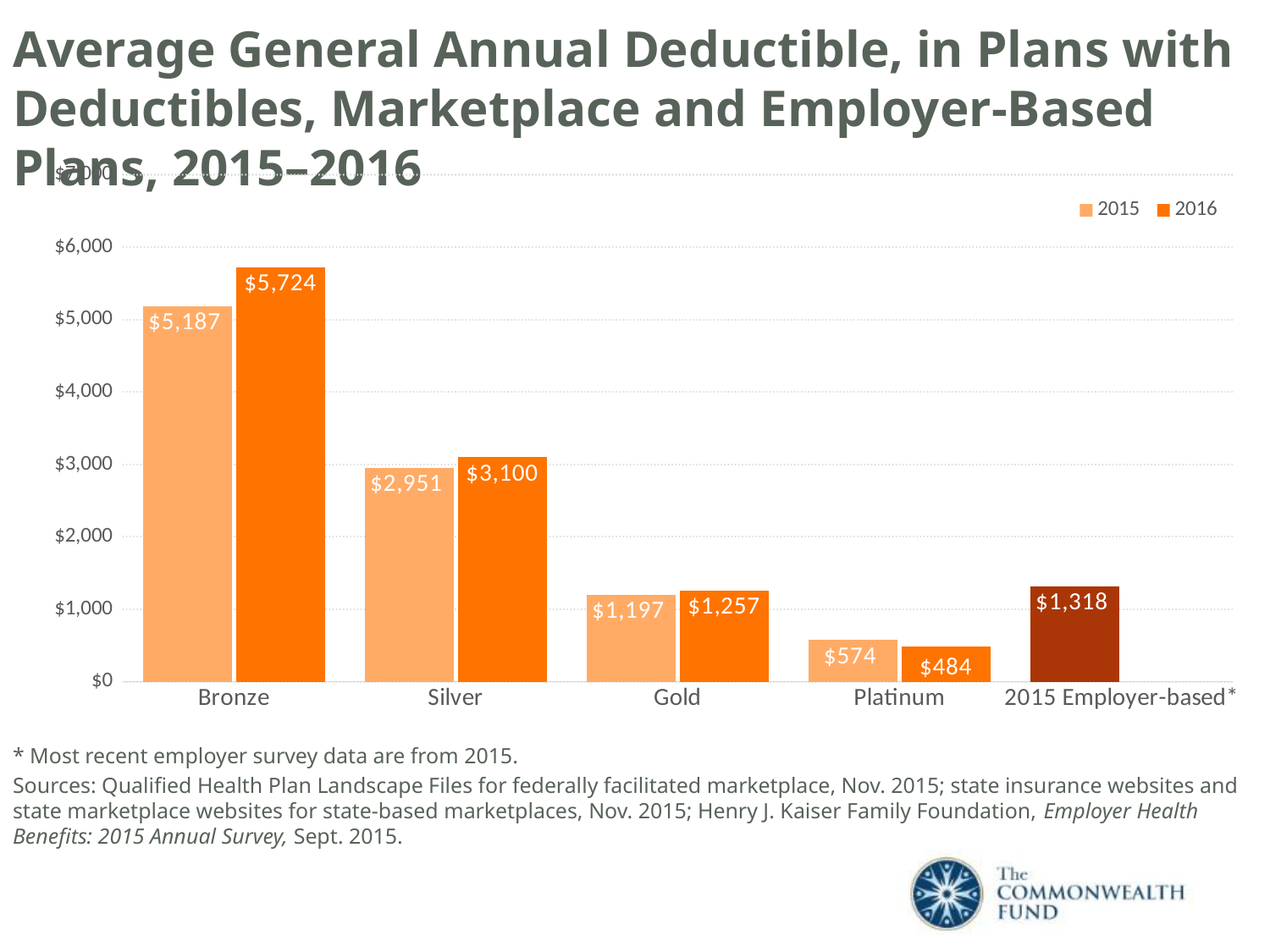
Which is larger, the 2015 Gold deductible or the 2015 Employer-based deductible? 2015 Employer-based Which plan category has the lowest 2015 deductible among the marketplace tiers? Platinum What is the 2016 average deductible for Platinum plans? $484 What kind of chart is shown on the slide? Bar chart What is the value shown for 2015 Employer-based plans? $1,318 What is the 2015 average deductible for Silver plans? $2,951 How many categories are shown on the x axis? 5 What is the 2016 average deductible for Bronze plans? $5,724 How many series does the legend list? 2 Which plan category has the highest 2016 deductible? Bronze Is the 2016 Silver deductible greater or less than $3,000? greater What is the difference between the 2016 and 2015 Bronze deductibles? $537